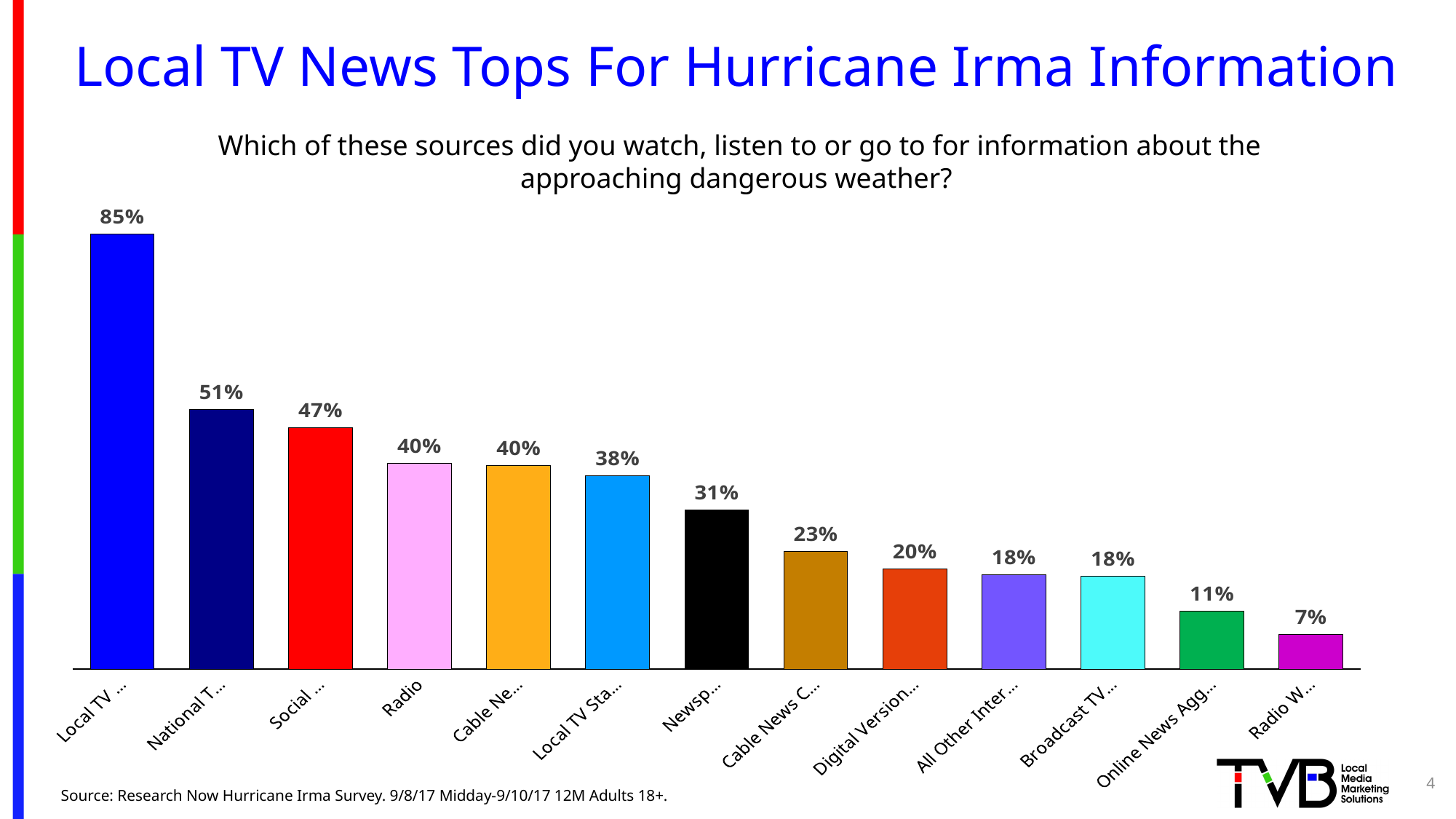
What kind of chart is shown on the slide? bar chart What is the value for Radio? 40% What is the lowest value shown in the chart? 7% What is the highest value shown in the chart? 85% What is the value of the last (rightmost) bar in the chart? 7% Do the bar values generally rise or fall from left to right across the chart? fall What is the value of the first (leftmost) bar in the chart? 85% What is the difference between the value for Radio and the value of the rightmost bar? 33% Which is larger: the value for Radio or the value of the black bar? Radio How many bars (categories) does the chart show? 13 What is the difference between the highest value (85%) and the second-highest value (51%)? 34% What is the title of the slide? Local TV News Tops For Hurricane Irma Information